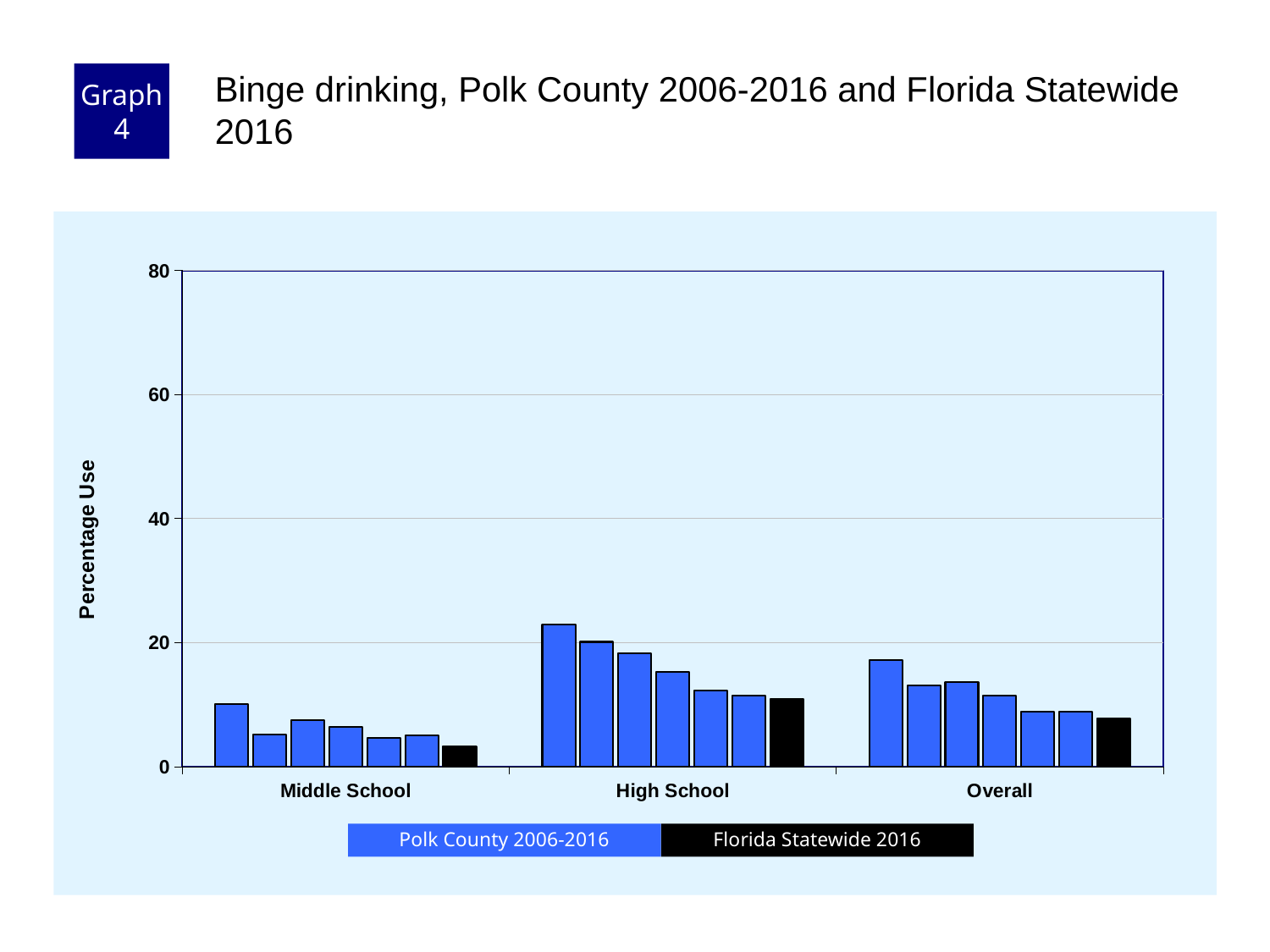
What is the label on the y axis? Percentage Use Is the Florida Statewide 2016 value for Middle School greater or less than 20? less How many categories are shown on the x axis? 3 Which category has the lowest bars overall? Middle School How many series does the legend list? 2 Which is larger, the Florida Statewide 2016 value for High School or for Middle School? High School What colour are the Florida Statewide 2016 bars? black Which category has the tallest bar? High School What kind of chart is shown on the slide? bar chart Do the Polk County 2006-2016 bars for High School rise or fall from left to right? fall Is the tallest Polk County bar for High School greater or less than 20? greater Is the tallest Polk County bar for Overall greater or less than 40? less